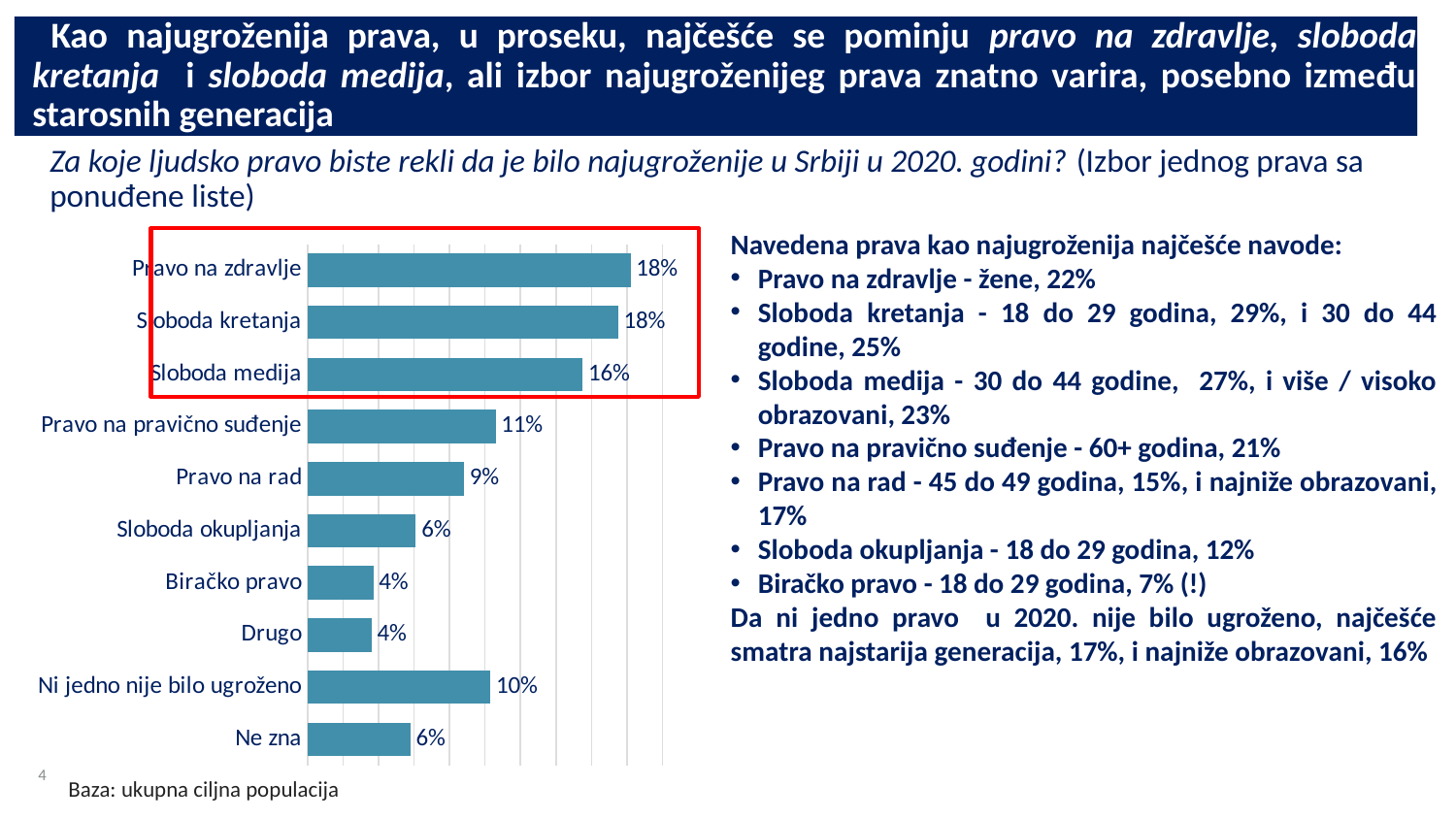
Which three categories are enclosed by the red box on the chart? Pravo na zdravlje, Sloboda kretanja, Sloboda medija What is the value for Ne zna? 6% Which is larger, the value for Pravo na rad or the value for Ni jedno nije bilo ugroženo? Ni jedno nije bilo ugroženo What is the value for Pravo na rad? 9% What is the value for Pravo na pravično suđenje? 11% What is the value for Sloboda medija? 16% What is the difference between the values for Pravo na pravično suđenje and Biračko pravo? 7% Which is larger, the value for Sloboda okupljanja or the value for Sloboda medija? Sloboda medija How many categories are shown in the chart? 10 What kind of chart is shown on the slide? Bar chart What is the difference between the values for Pravo na zdravlje and Sloboda medija? 2% What is the value for Ni jedno nije bilo ugroženo? 10%